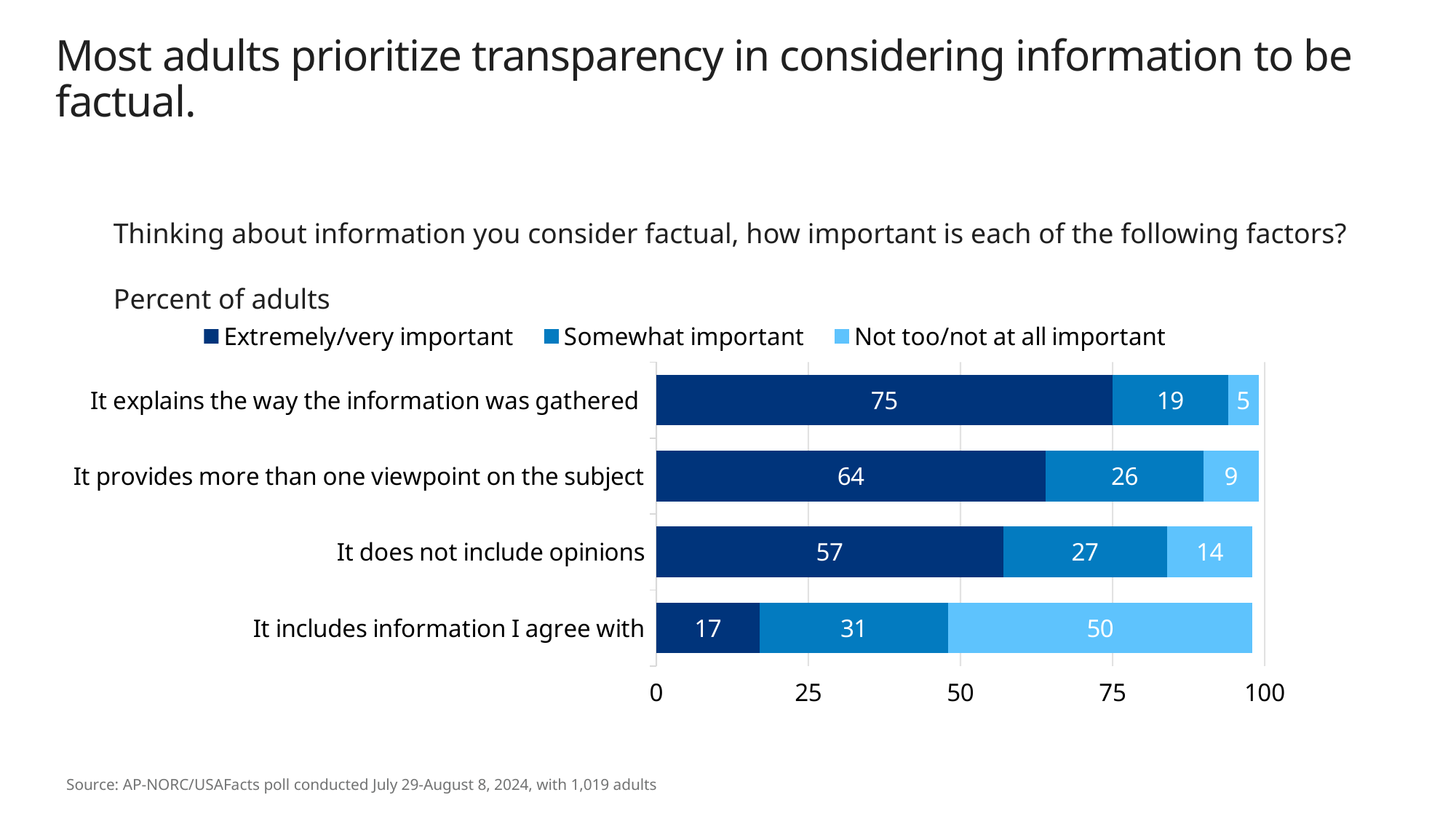
What is the total of the stacked bar for 'It does not include opinions'? 98 What is the difference between the extremely/very important shares for 'It explains the way the information was gathered' and 'It provides more than one viewpoint on the subject'? 11 What is the label of the series shown in the lightest blue in the legend? Not too/not at all important Which is larger: the somewhat important share for 'It provides more than one viewpoint on the subject' or for 'It explains the way the information was gathered'? It provides more than one viewpoint on the subject What percent of adults say it is not too/not at all important that information includes information they agree with? 50 How many series does the legend list? 3 Which factor has the lowest share of adults rating it extremely/very important? It includes information I agree with What percent of adults say it is extremely/very important that information explains the way it was gathered? 75 How many factors are shown in the chart? 4 Which factor has the highest share of adults rating it extremely/very important? It explains the way the information was gathered What kind of chart is shown on the slide? Stacked bar chart What percent of adults say it is somewhat important that information does not include opinions? 27